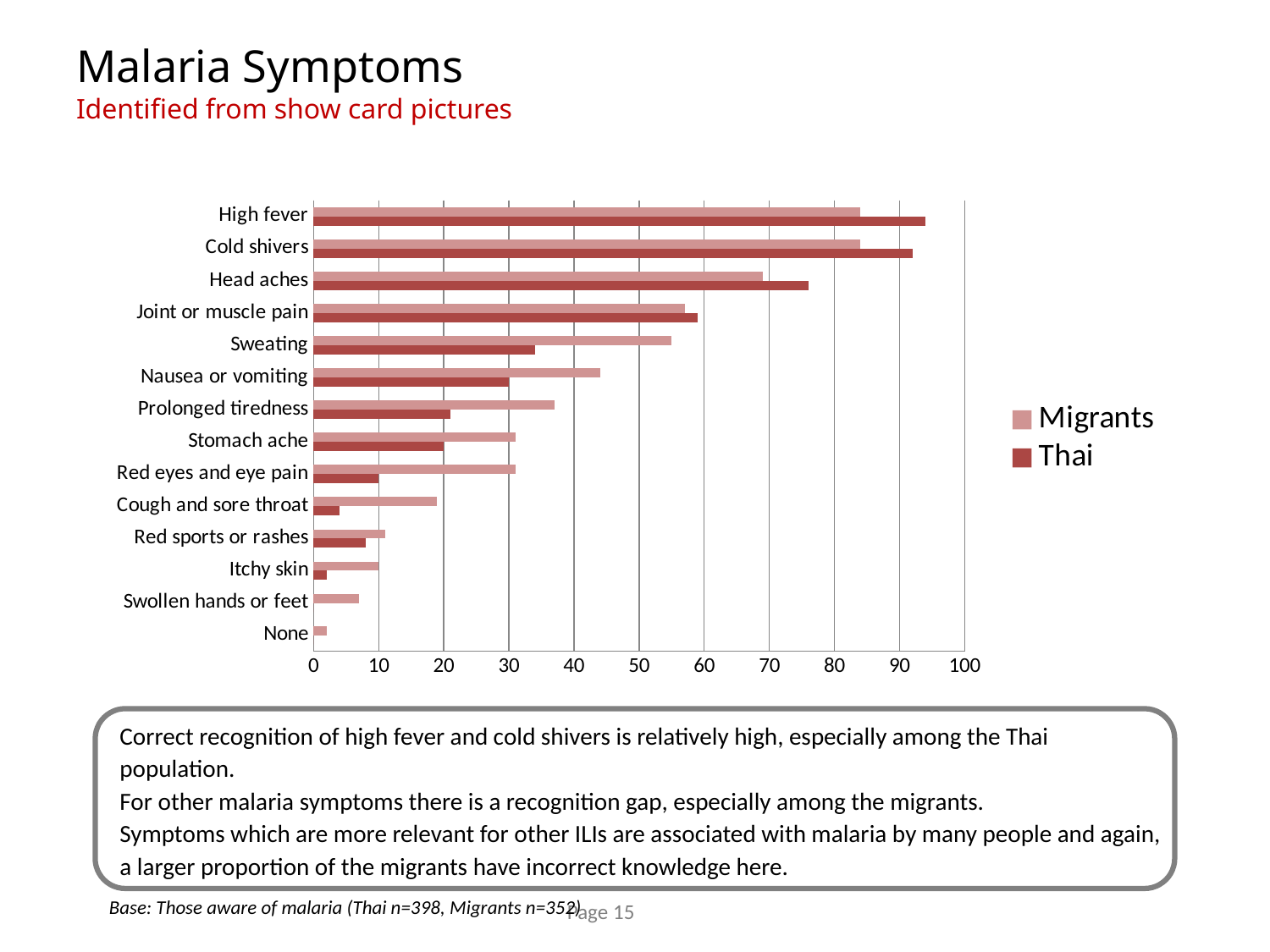
For Sweating, which series has the larger value, Migrants or Thai? Migrants Is the Migrants value for Swollen hands or feet greater or less than 10? less Is the Thai value for High fever greater or less than 90? greater For Head aches, which series has the larger value, Migrants or Thai? Thai What kind of chart is shown on the slide? bar chart Is the Thai value for Cough and sore throat greater or less than 10? less How many symptom categories are plotted on the chart? 14 What are the two series named in the legend? Migrants and Thai Which category has the lowest Migrants value? None How many series does the legend list? 2